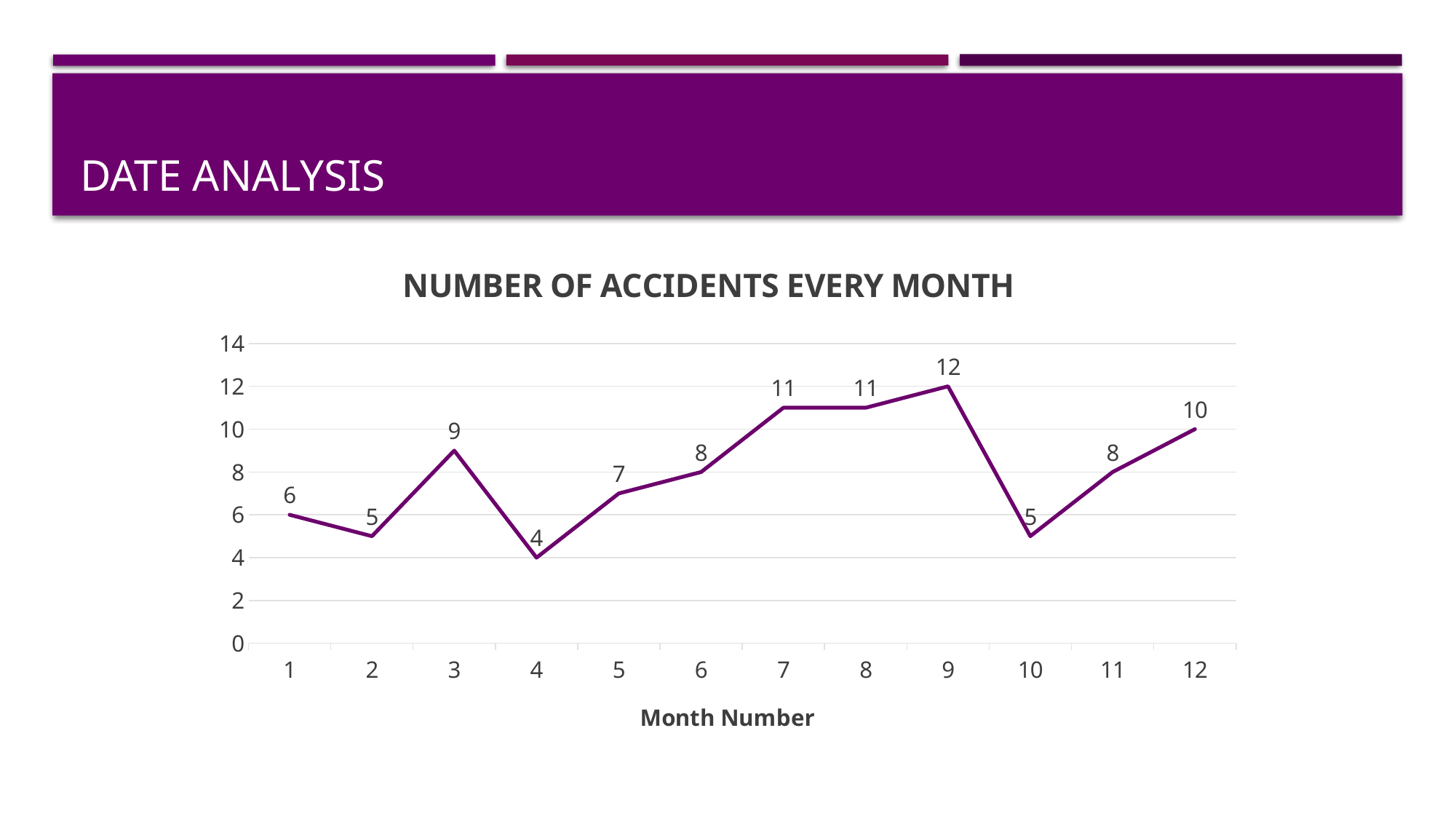
What is the difference in the number of accidents between month 9 and month 4? 8 Is the number of accidents in month 7 greater or less than 10? greater Which month has the lowest number of accidents? 4 How many months are plotted on the chart? 12 What kind of chart is shown on the slide? Line chart Do the number of accidents rise or fall from month 4 to month 9? Rise What is the number of accidents in month 9? 12 Which month has the highest number of accidents? 9 What is the number of accidents in month 12? 10 What is the title of the chart? Number of Accidents Every Month What is the number of accidents in month 3? 9 Which month has more accidents, month 3 or month 6? Month 3